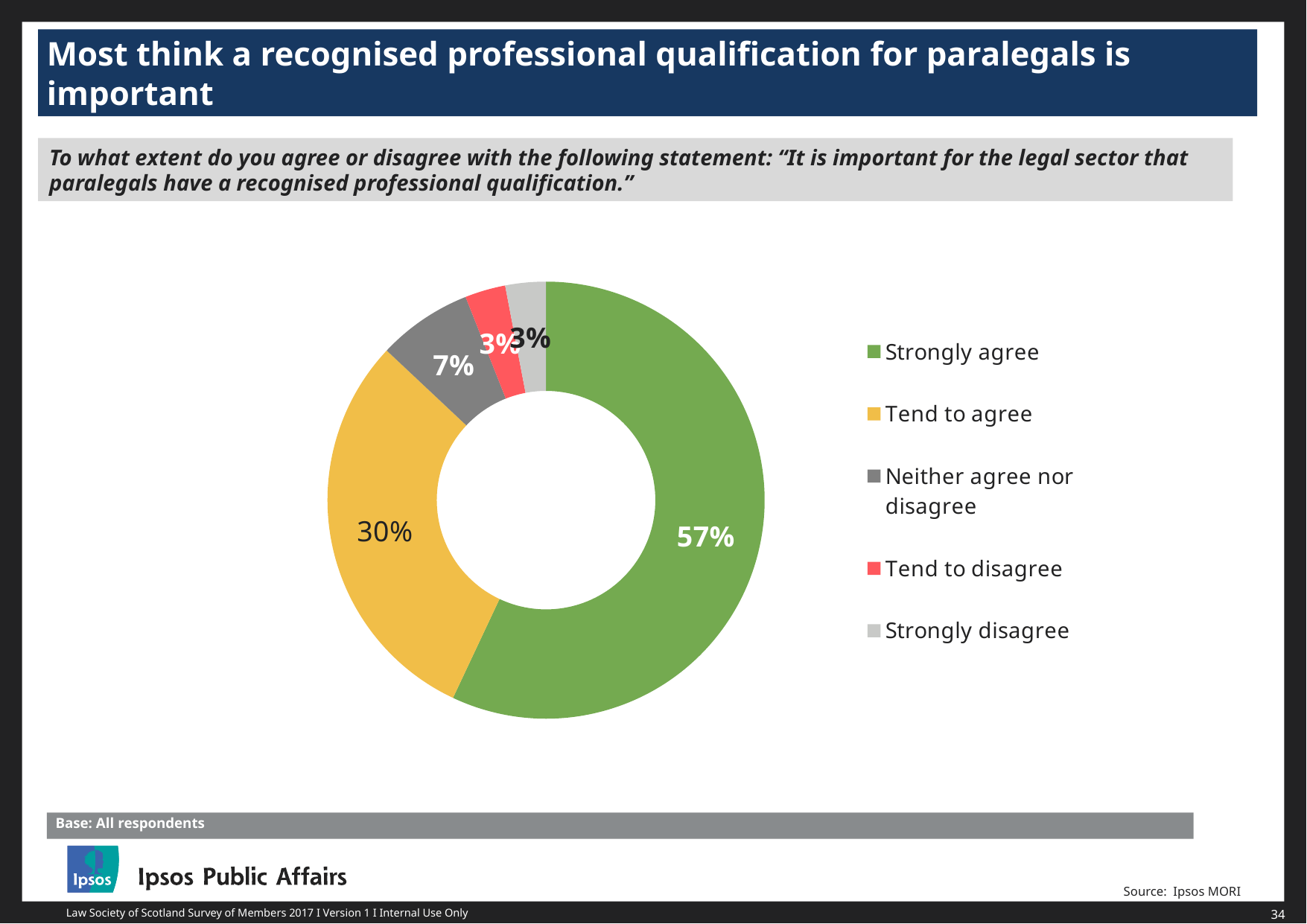
Which response category has the largest share of the pie? Strongly agree What is the difference in percentage points between 'Strongly agree' and 'Tend to agree'? 27 What colour represents 'Strongly agree' in the chart? Green Which is larger, the share for 'Tend to agree' or the share for 'Neither agree nor disagree'? Tend to agree What is the combined percentage of respondents who strongly agree or tend to agree? 87% What percentage of respondents strongly agree that it is important for paralegals to have a recognised professional qualification? 57% How many response categories does the legend list? 5 What kind of chart is shown on the slide? Pie chart (doughnut) What is the base for the chart, as stated on the slide? All respondents What percentage of respondents neither agree nor disagree? 7% What is the difference in percentage points between 'Neither agree nor disagree' and 'Tend to disagree'? 4 What percentage of respondents tend to agree? 30%